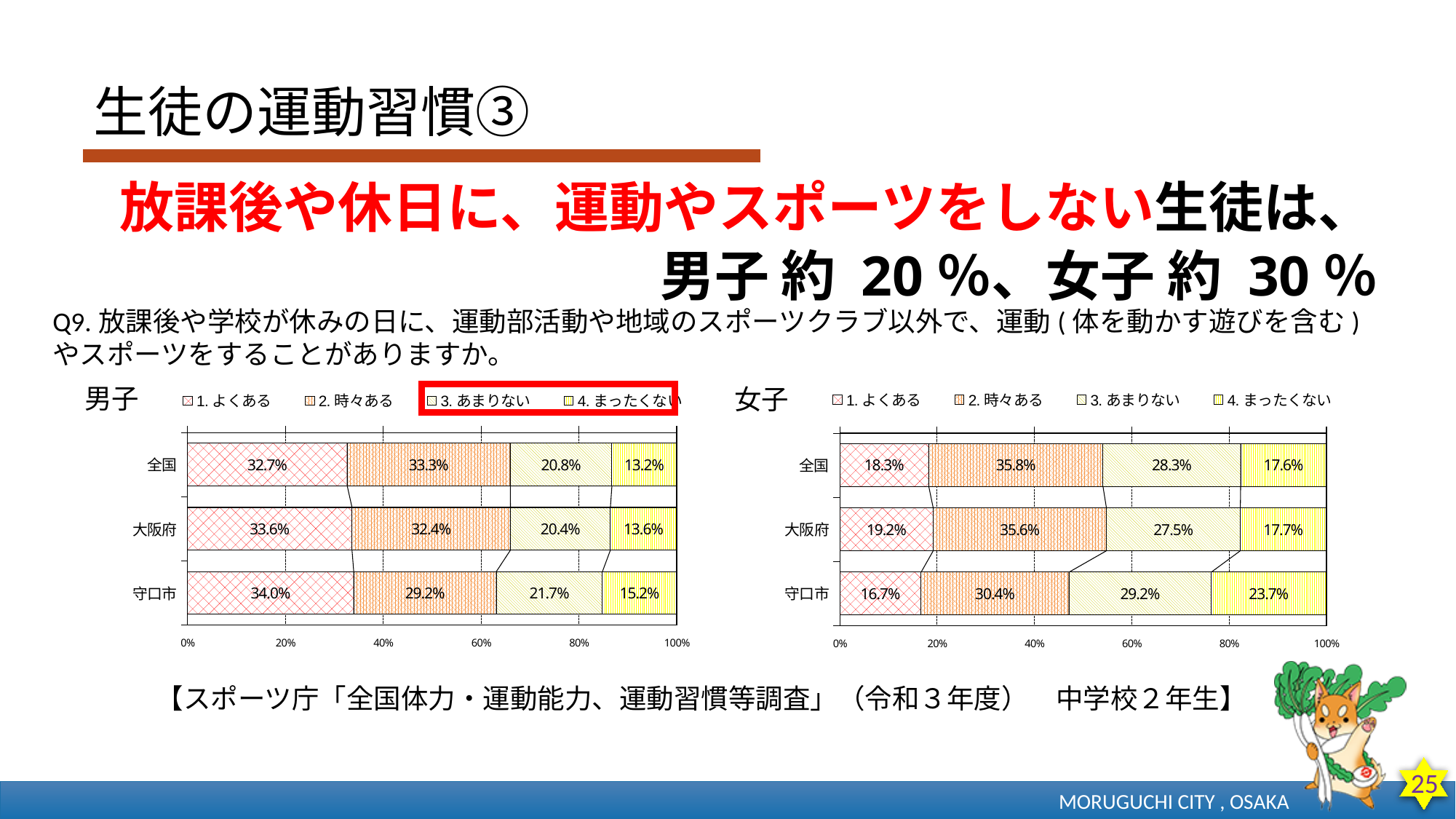
In the 女子 chart, what is the value for 3. あまりない for 大阪府? 27.5% In the 女子 chart, what is the difference between the 4. まったくない values for 守口市 and 全国? 6.1% In the 男子 chart, what is the value for 4. まったくない for 守口市? 15.2% In the 女子 chart, which category has the lowest value for 2. 時々ある? 守口市 What kind of chart is the 男子 chart? Stacked bar chart How many categories are shown on the y axis of the 男子 chart? 3 Which legend entries in the 男子 chart are outlined with a red box? 3. あまりない and 4. まったくない How many series does the legend of the 女子 chart list? 4 In the 男子 chart, which is larger for 全国: 1. よくある or 2. 時々ある? 2. 時々ある In the 男子 chart, which category has the highest value for 1. よくある? 守口市 In the 女子 chart, what is the value for 1. よくある for 全国? 18.3% In the 女子 chart, what is the combined value of 3. あまりない and 4. まったくない for 守口市? 52.9%